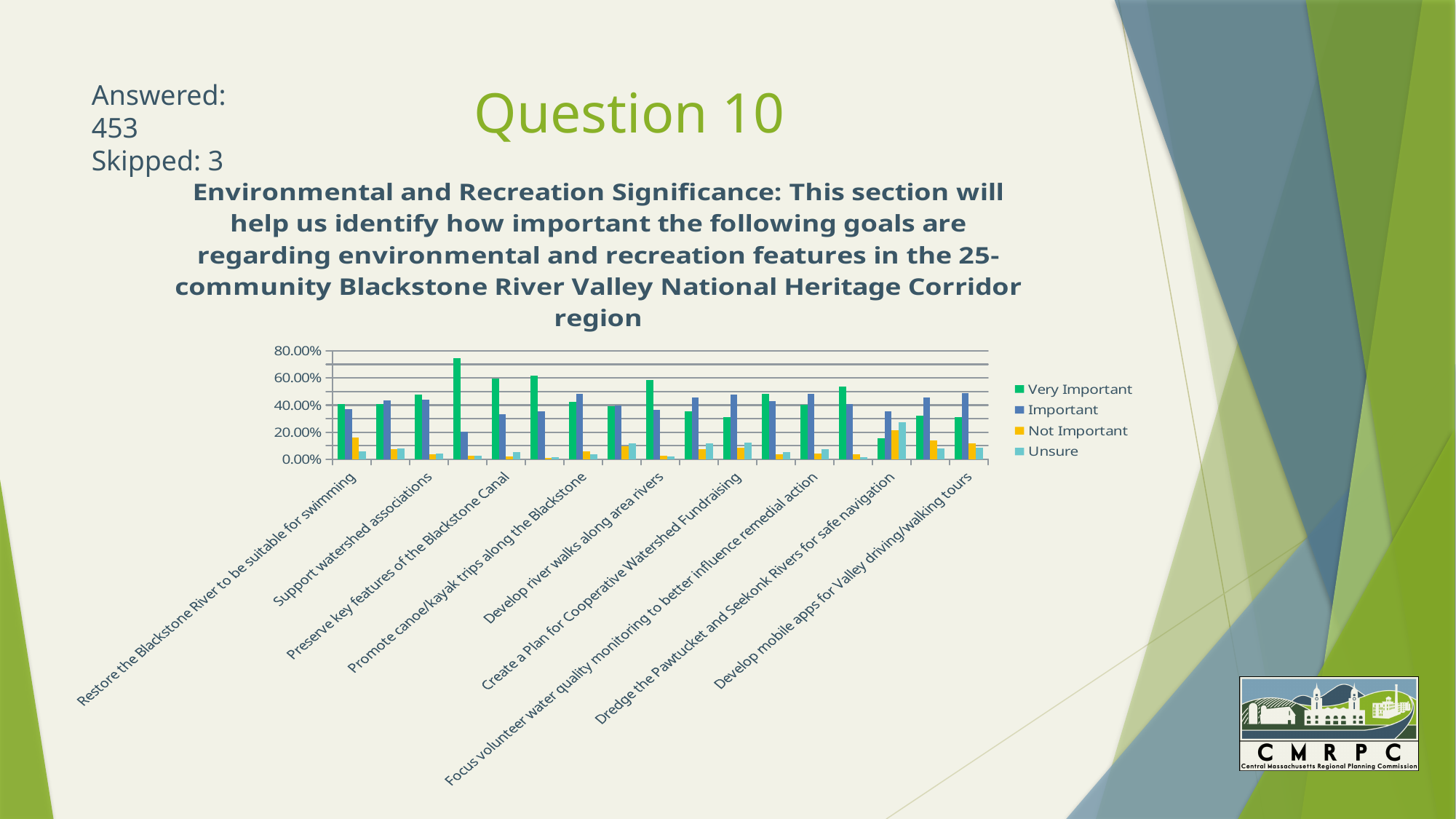
How many series does the chart legend list? 4 Is the Very Important value for "Develop river walks along area rivers" greater or less than 40.00%? greater Among the labeled categories, which has the lowest Very Important value? Dredge the Pawtucket and Seekonk Rivers for safe navigation Which series is shown in green in the chart legend? Very Important What kind of chart is shown on the slide? bar chart Is the Very Important value for "Create a Plan for Cooperative Watershed Fundraising" greater or less than 40.00%? less For "Dredge the Pawtucket and Seekonk Rivers for safe navigation", which is larger: Very Important or Important? Important Is the Very Important value for "Dredge the Pawtucket and Seekonk Rivers for safe navigation" greater or less than 20.00%? less What is the highest value shown on the chart's vertical axis? 80.00% For "Preserve key features of the Blackstone Canal", which is larger: Very Important or Important? Very Important